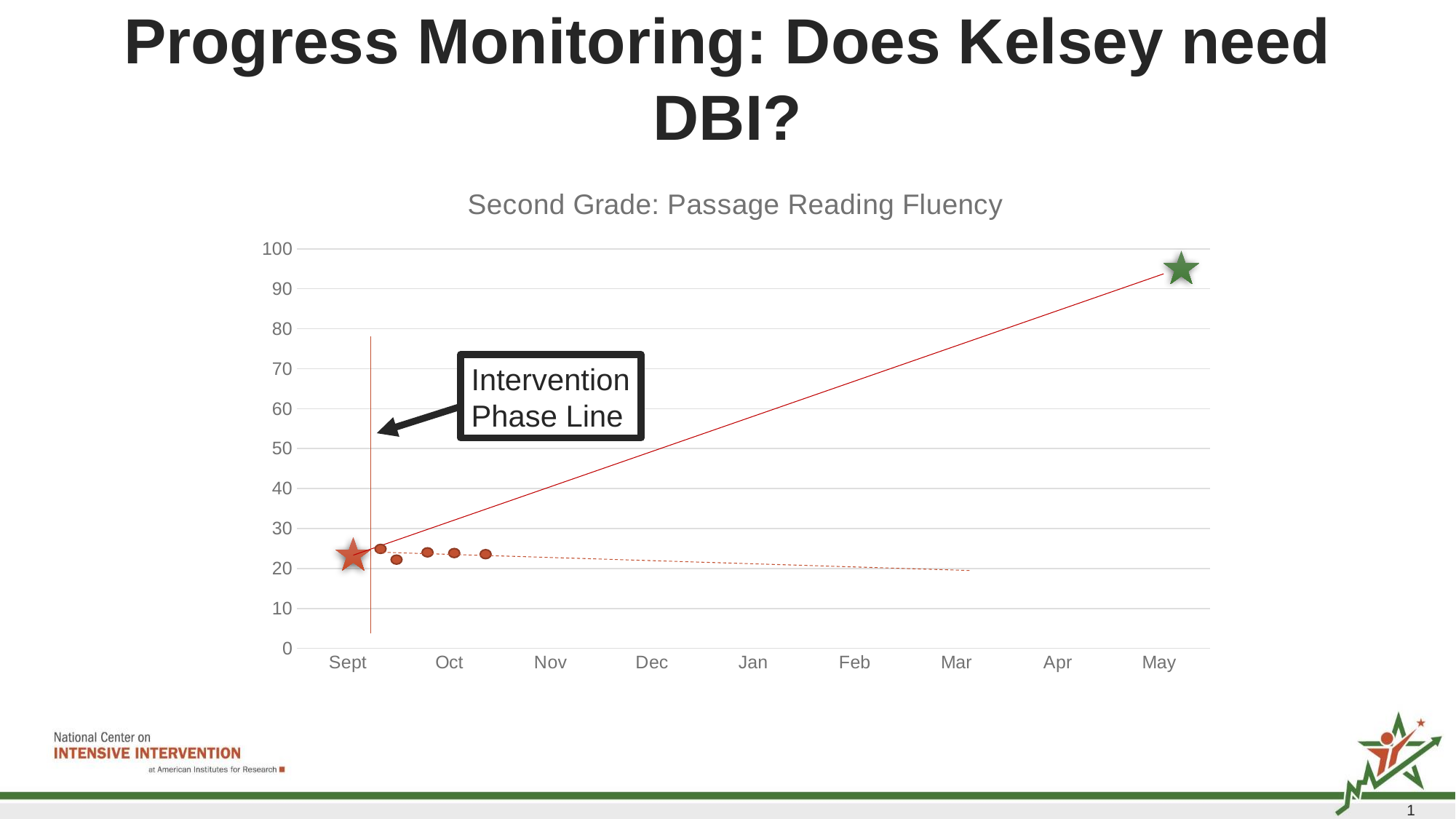
Is the value of the red star at Sept greater or less than 30? less What kind of chart is shown on the slide? line chart Which is higher, the green star at May or the red star at Sept? the green star at May How many months are labelled along the x axis of the chart? 9 Are the plotted red data points in Sept and Oct greater or less than 30? less Is the value of the green star at May greater or less than 90? greater What is the first month labelled on the x axis? Sept What is the highest value shown on the y axis? 100 Does the solid red goal line rise or fall from Sept to May? rise Does the dashed trend line through the data points rise or fall from Sept to Mar? fall What is the title of the chart? Second Grade: Passage Reading Fluency What does the text box with the arrow label the vertical line near Sept as? Intervention Phase Line